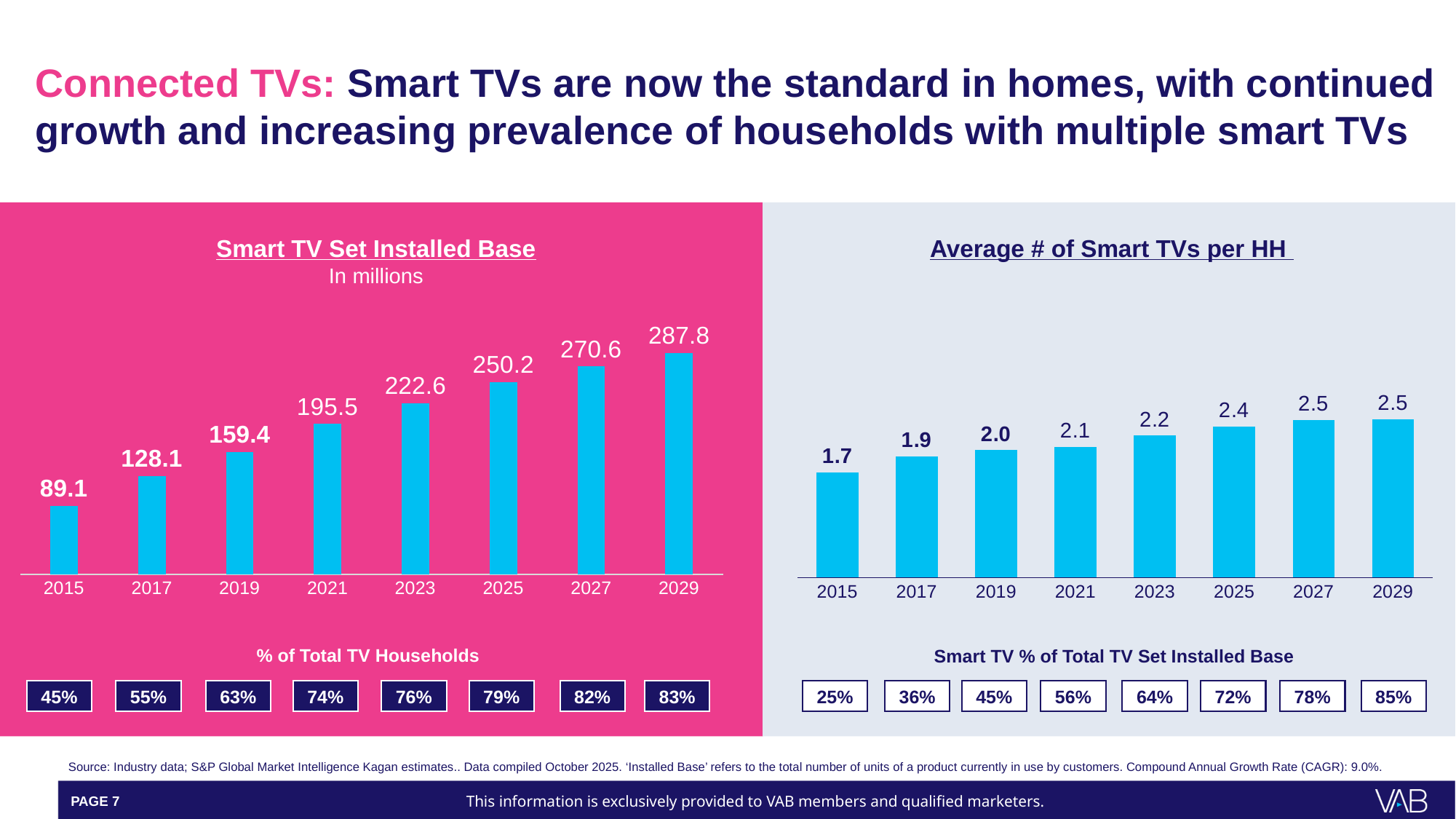
In the 'Smart TV Set Installed Base' chart, which year has the lowest value? 2015 In the 'Smart TV Set Installed Base' chart, how many years are plotted? 8 What kind of chart is the 'Average # of Smart TVs per HH' chart? bar chart In the 'Smart TV Set Installed Base' chart, which year has the highest value? 2029 In the 'Smart TV Set Installed Base' chart, what is the value for 2021? 195.5 In the 'Average # of Smart TVs per HH' chart, what is the difference between the 2025 and 2017 values? 0.5 In the 'Average # of Smart TVs per HH' chart, which is larger, the value for 2019 or the value for 2025? 2025 In the 'Average # of Smart TVs per HH' chart, what is the value for 2023? 2.2 In the 'Smart TV Set Installed Base' chart, what is the difference between the 2029 and 2015 values? 198.7 What unit is stated under the title of the 'Smart TV Set Installed Base' chart? In millions In the 'Average # of Smart TVs per HH' chart, what is the value for 2015? 1.7 In the 'Smart TV Set Installed Base' chart, do the values rise or fall from 2015 to 2029? rise